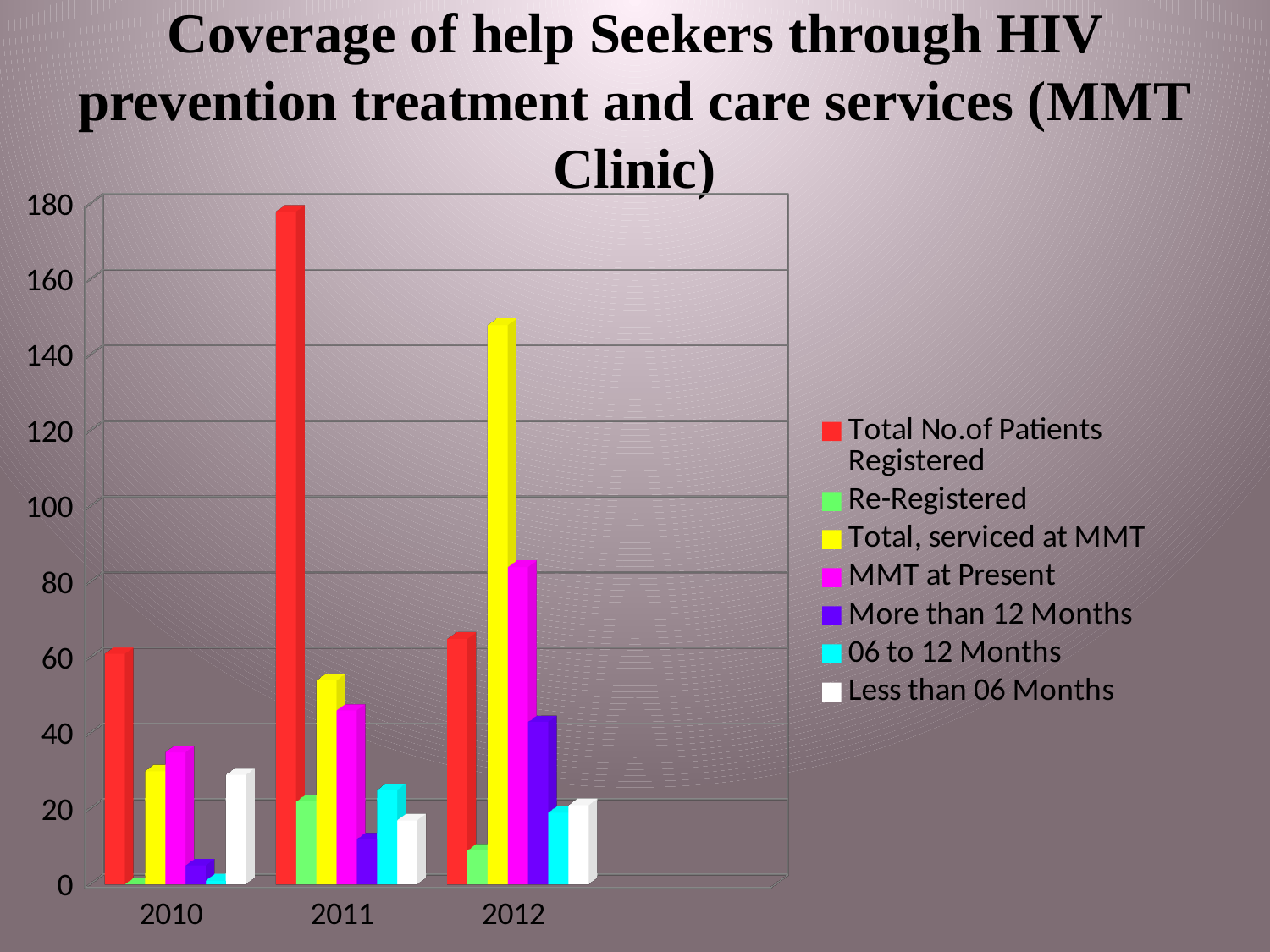
How many years are shown on the x axis of the chart? 3 Is the value for Re-Registered in 2011 greater or less than 40? less Which series has the highest value in 2012? Total, serviced at MMT Does the value for Total, serviced at MMT rise or fall from 2010 to 2012? rise In which year is the value for Total No.of Patients Registered the highest? 2011 How many series does the chart's legend list? 7 Is the value for Total No.of Patients Registered in 2011 greater or less than 160? greater Which is larger: Total, serviced at MMT in 2011 or in 2012? 2012 Which series has the lowest value in 2010? Re-Registered Is the value for MMT at Present in 2012 greater or less than 60? greater What kind of chart is shown on the slide? bar chart